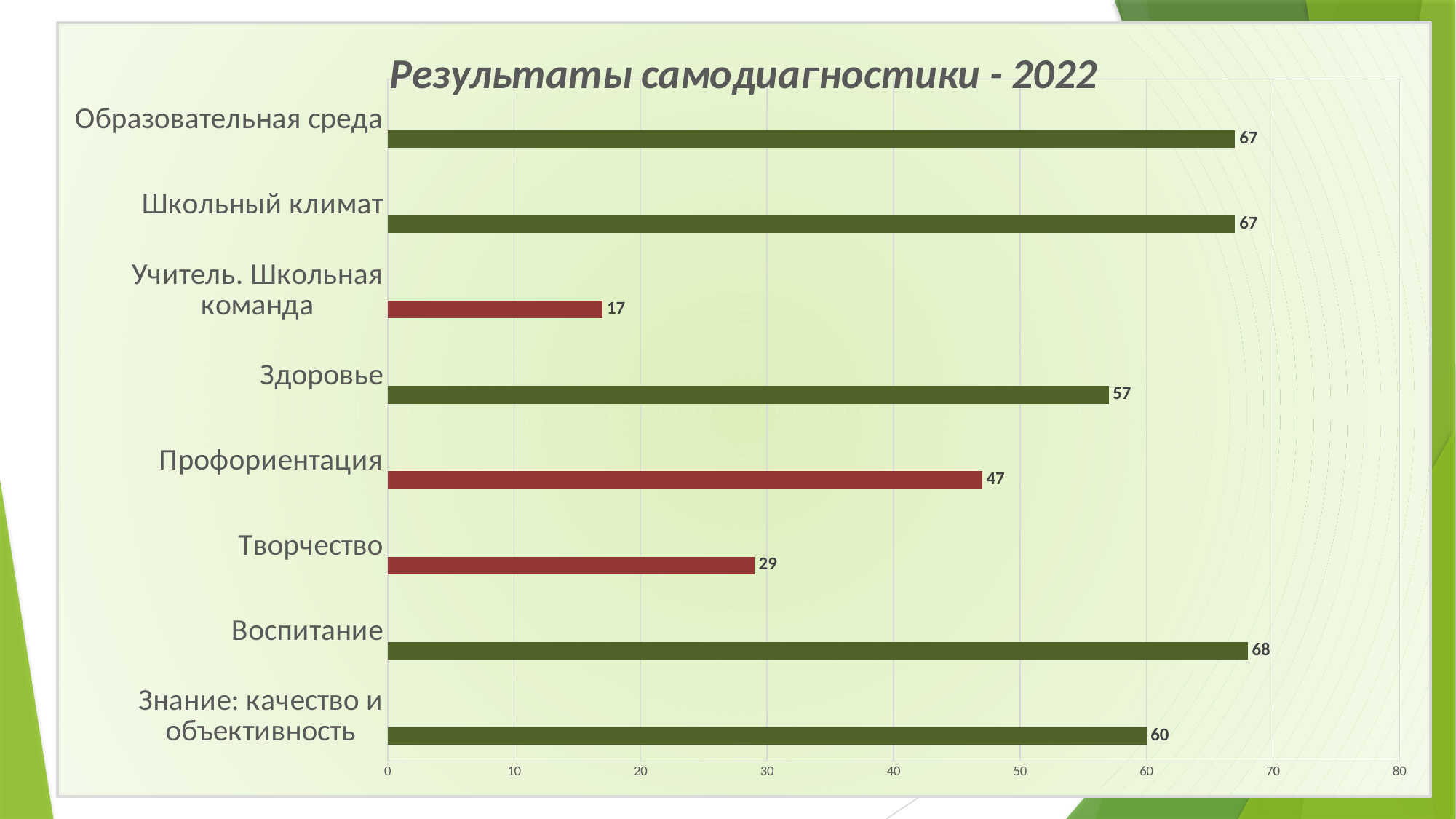
Which is larger, the value for Профориентация or the value for Творчество? Профориентация What is the value for Профориентация? 47 Which category has the highest value? Воспитание Which category has the lowest value? Учитель. Школьная команда What is the difference between the values for Здоровье and Творчество? 28 What is the value for Учитель. Школьная команда? 17 Is the value for Здоровье greater or less than 50? greater How many categories are shown in the chart? 8 What is the value for Знание: качество и объективность? 60 What kind of chart is shown on the slide? bar chart What is the title of the chart? Результаты самодиагностики - 2022 What is the value for Воспитание? 68